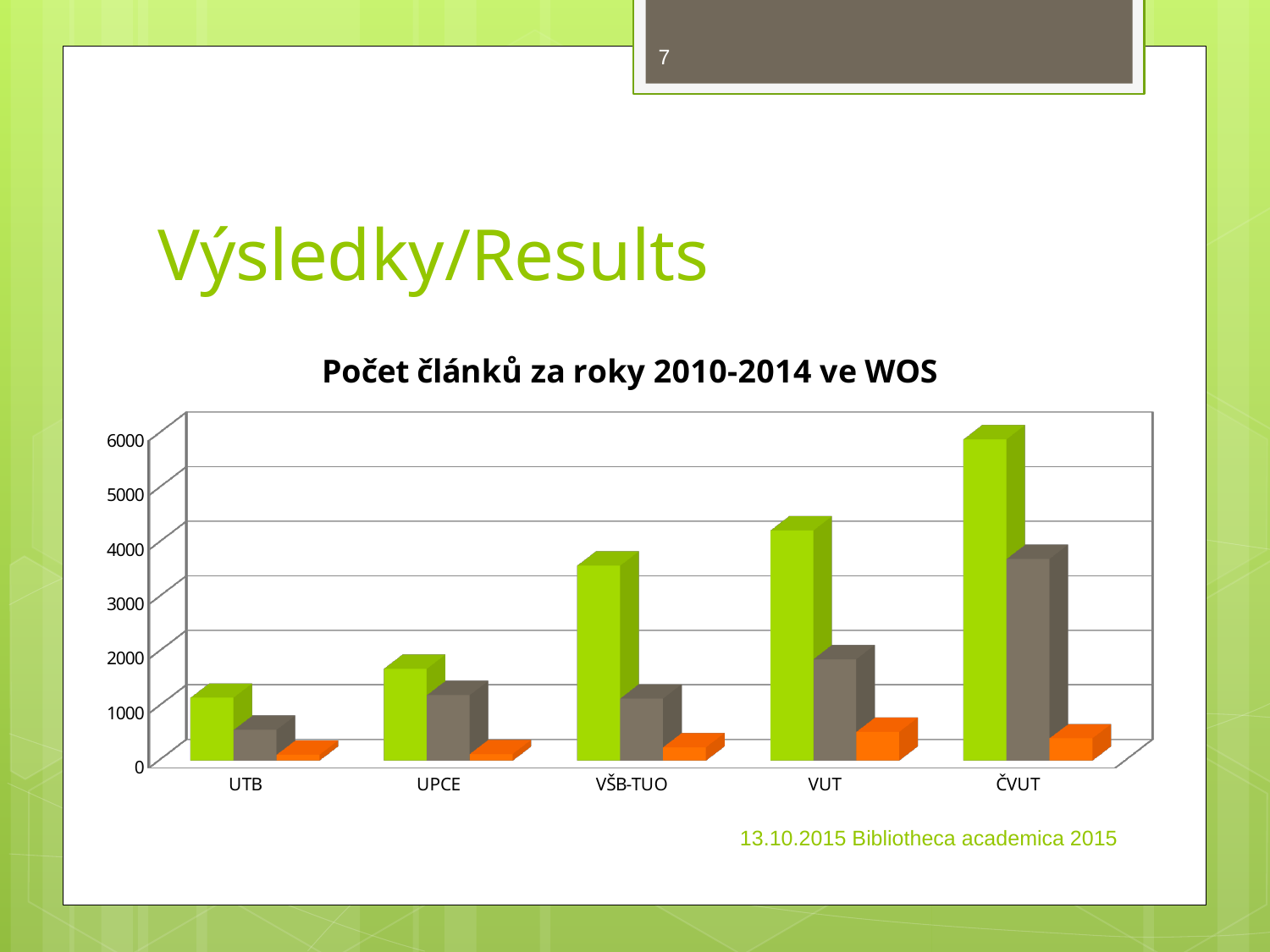
Is the green bar for ČVUT greater or less than 5000? greater Which is larger for VŠB-TUO, the green bar or the grey bar? The green bar Is the grey bar for UTB greater or less than 1000? less Is the grey bar for ČVUT greater or less than 3000? greater What is the title of the chart? Počet článků za roky 2010-2014 ve WOS Which institution has the tallest green bar? ČVUT What kind of chart is shown on the slide? Bar chart Which institution has the shortest green bar? UTB Which is larger, the grey bar for ČVUT or the grey bar for VUT? ČVUT How many categories (institutions) are shown on the x axis? 5 Do the green bars rise or fall from UTB to ČVUT along the x axis? Rise